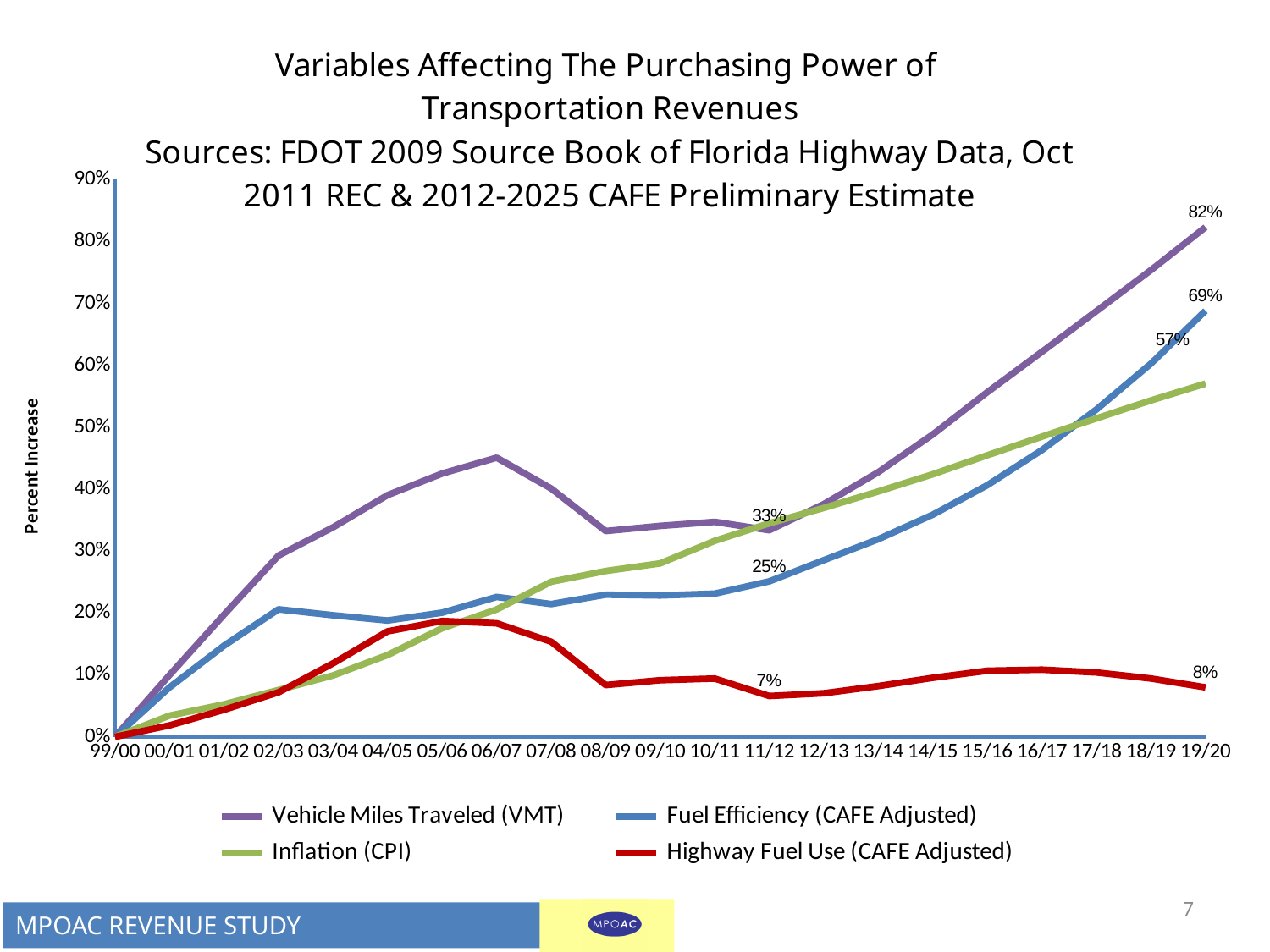
What is the value for Highway Fuel Use (CAFE Adjusted) in 11/12? 7% How many series does the legend list? 4 What is the difference between Vehicle Miles Traveled (VMT) and Fuel Efficiency (CAFE Adjusted) in 19/20? 13% What kind of chart is shown on the slide? line chart What is the value for Fuel Efficiency (CAFE Adjusted) in 19/20? 69% Is the value for Vehicle Miles Traveled (VMT) in 06/07 greater or less than 40%? greater Which series has the highest value in 19/20? Vehicle Miles Traveled (VMT) What is the value for Inflation (CPI) in 19/20? 57% What is the title of the vertical axis? Percent Increase What is the value for Highway Fuel Use (CAFE Adjusted) in 19/20? 8% Which series has the lowest value in 19/20? Highway Fuel Use (CAFE Adjusted) What is the value for Vehicle Miles Traveled (VMT) in 19/20? 82%